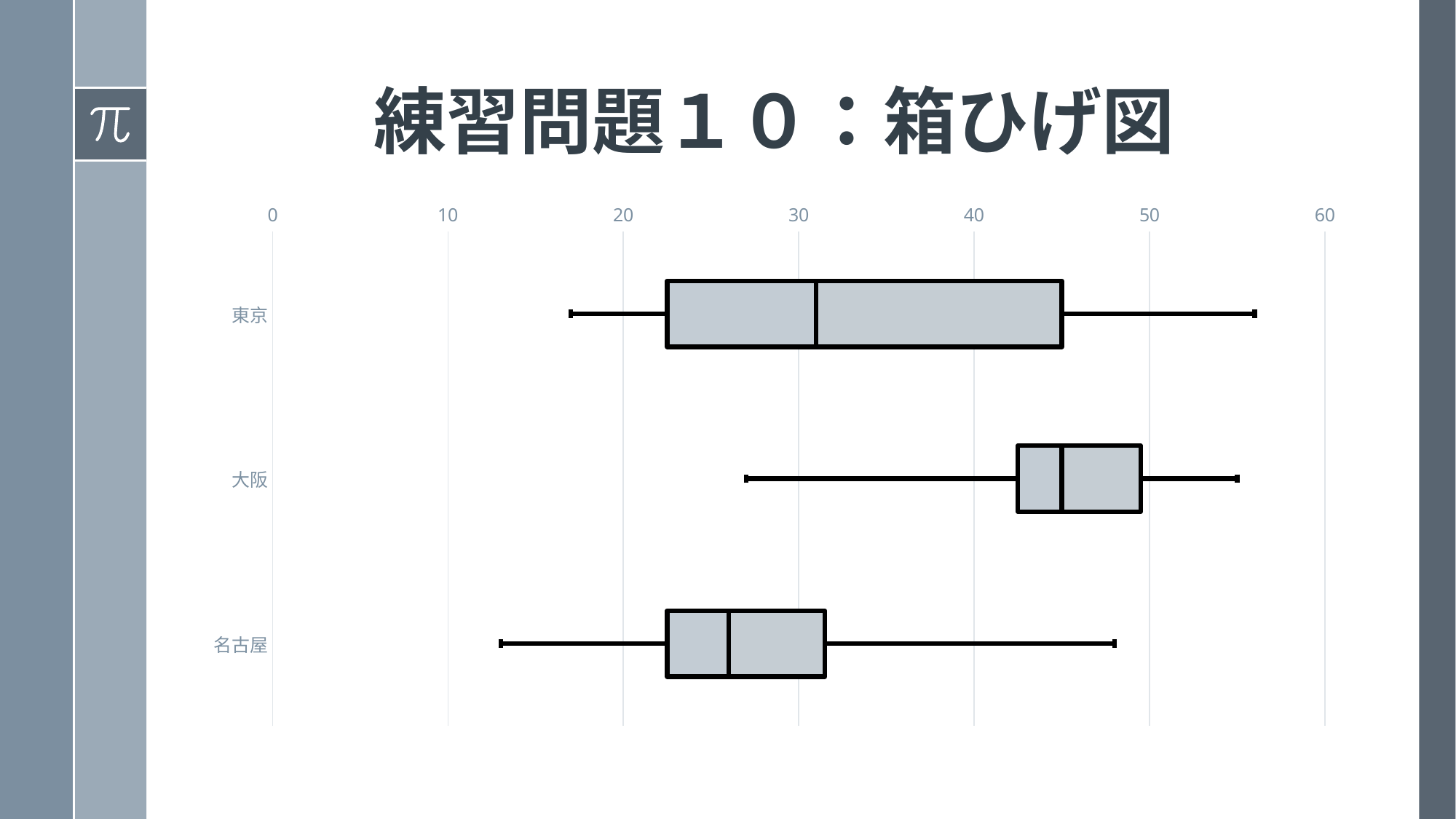
What kind of chart is shown on the slide? Box plot (box-and-whisker chart) Is the minimum (lower whisker end) for 名古屋 greater or less than 20? less Is the median for 東京 greater or less than 40? less What is the highest value shown on the horizontal axis? 60 Is the median for 名古屋 greater or less than 30? less What is the title of the slide? 練習問題１０：箱ひげ図 Which category has the highest median? 大阪 Which category has the widest box (largest interquartile range), 東京 or 大阪? 東京 How many categories are plotted on the chart? 3 Which category has the lowest median? 名古屋